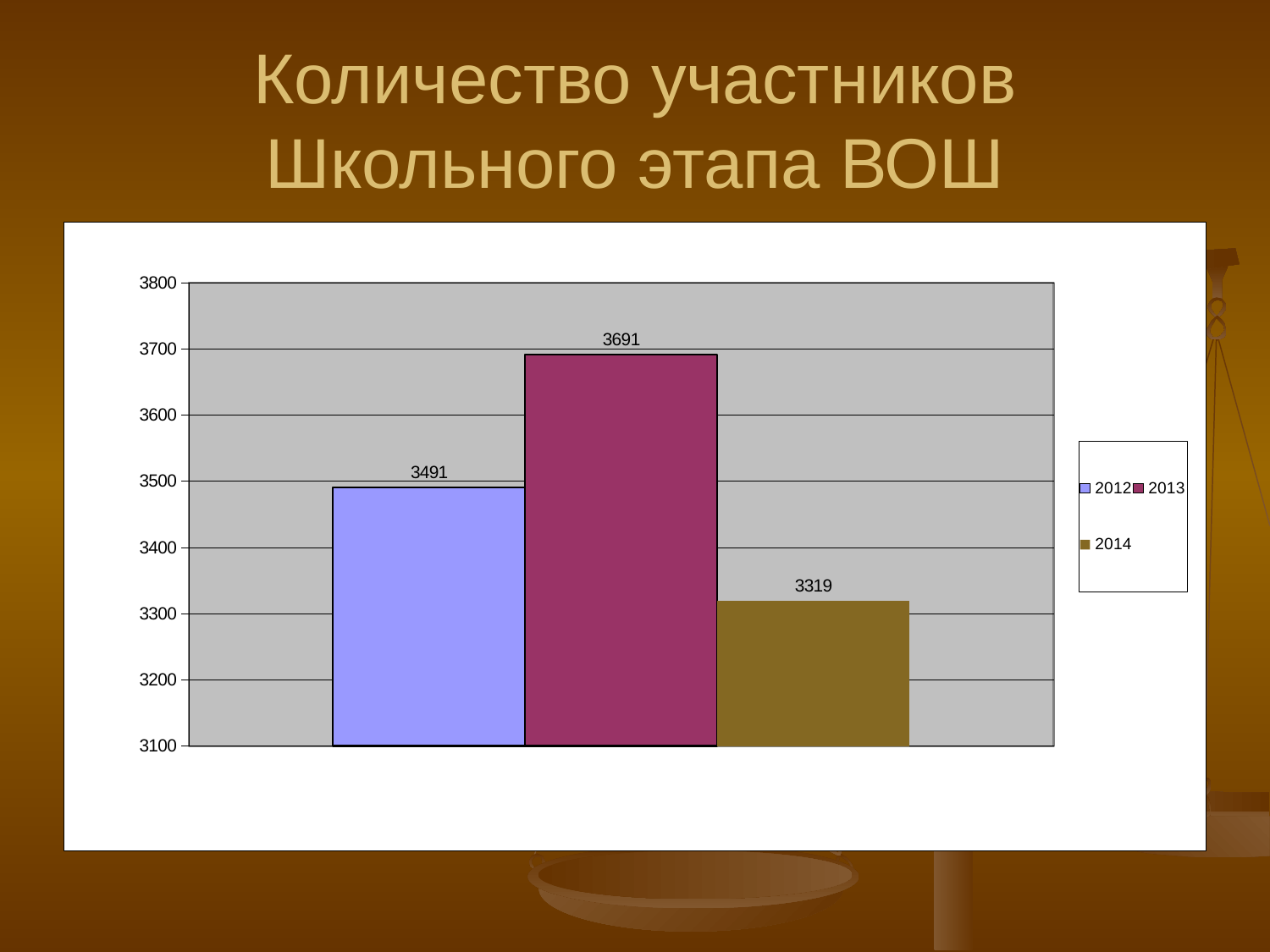
Which is larger, the value for 2012 or the value for 2014? 2012 What is the value for 2013? 3691 How many series does the legend list? 3 What kind of chart is shown on the slide? bar chart Which year has the highest value? 2013 What is the value for 2012? 3491 What is the value for 2014? 3319 Which year has the lowest value? 2014 What is the difference between the values for 2012 and 2014? 172 What is the difference between the values for 2013 and 2012? 200 Is the value for 2014 greater or less than 3400? less What is the title of the slide? Количество участников Школьного этапа ВОШ